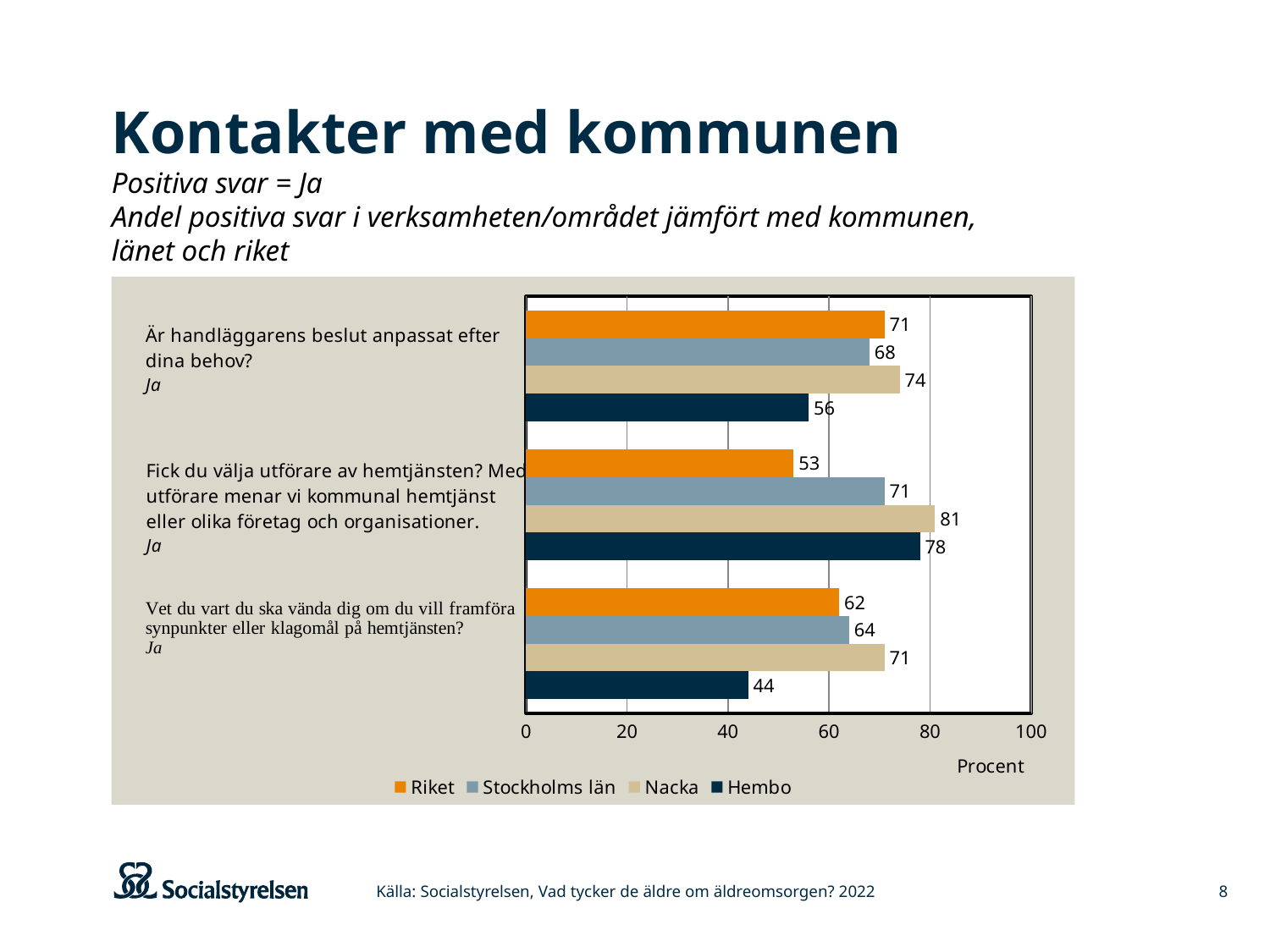
What is the value for Hembo on the question "Är handläggarens beslut anpassat efter dina behov?"? 56 What is the value for Riket on the question "Vet du vart du ska vända dig om du vill framföra synpunkter eller klagomål på hemtjänsten?"? 62 What is the value for Nacka on the question "Fick du välja utförare av hemtjänsten?"? 81 What unit label is shown on the x axis of the chart? Procent What kind of chart is shown on the slide? Bar chart What is the difference between the Nacka and Hembo values on the question "Är handläggarens beslut anpassat efter dina behov?"? 18 How many series does the legend list? 4 Which series has the highest value on the question "Fick du välja utförare av hemtjänsten?"? Nacka Which series has the lowest value on the question "Vet du vart du ska vända dig om du vill framföra synpunkter eller klagomål på hemtjänsten?"? Hembo What is the value for Stockholms län on the question "Är handläggarens beslut anpassat efter dina behov?"? 68 On the question "Fick du välja utförare av hemtjänsten?", which is larger: the value for Riket or the value for Hembo? Hembo How many questions (categories) are shown on the chart? 3